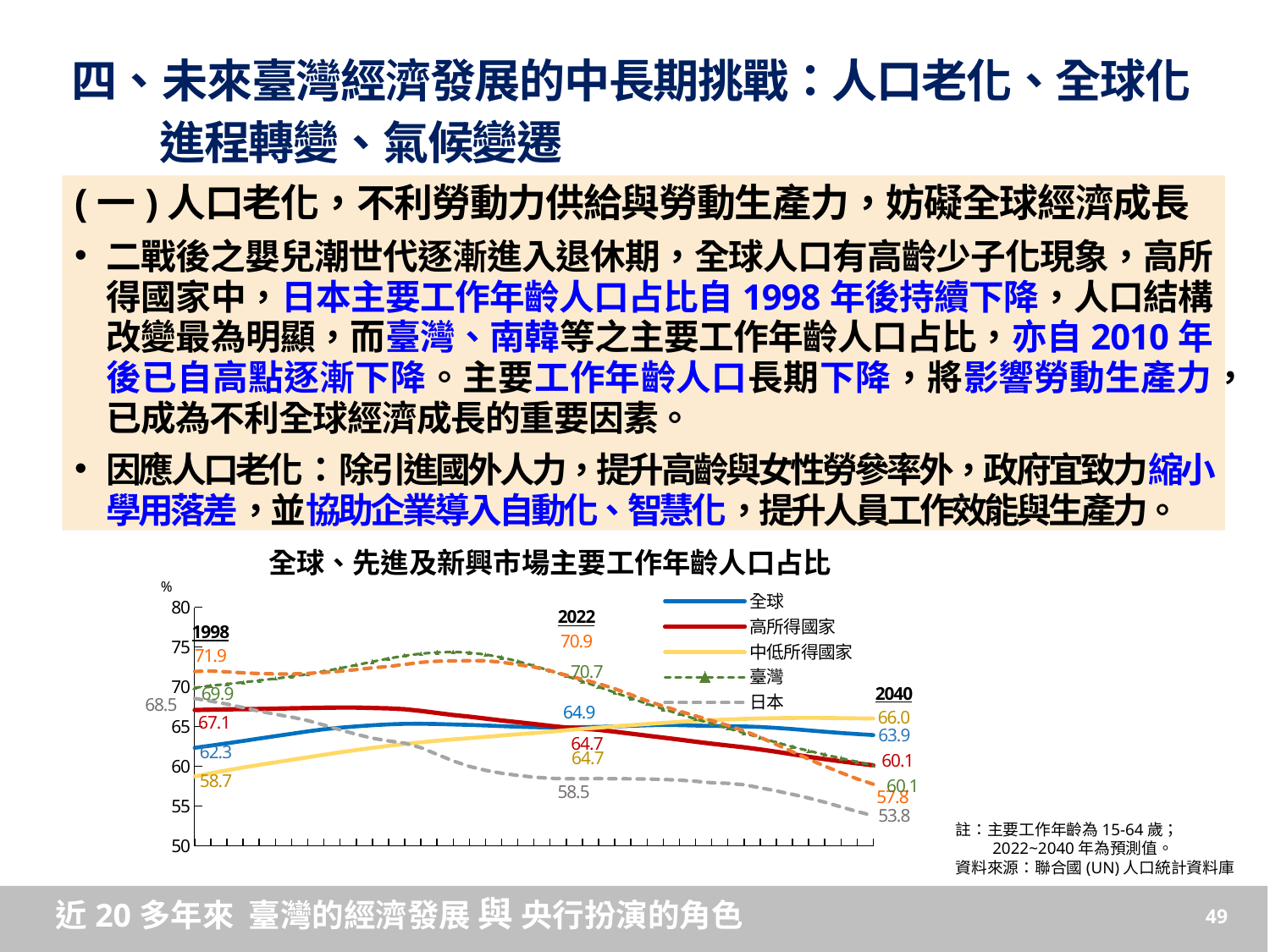
How many series does the chart legend list? 5 Which series has the lowest value in 2040? 日本 Which series has the highest value in 2040? 中低所得國家 What is the value for 日本 in 2040? 53.8 What is the value for 日本 in 1998? 68.5 What kind of chart is shown on the slide? line chart Does the value for 中低所得國家 rise or fall from 1998 to 2040? rise In 1998, which is larger: the value for 全球 or the value for 中低所得國家? 全球 What is the value for 中低所得國家 in 1998? 58.7 By how much does the value for 日本 fall from 1998 to 2040? 14.7 What is the value for 高所得國家 in 2040? 60.1 What is the value for 全球 in 2022? 64.9